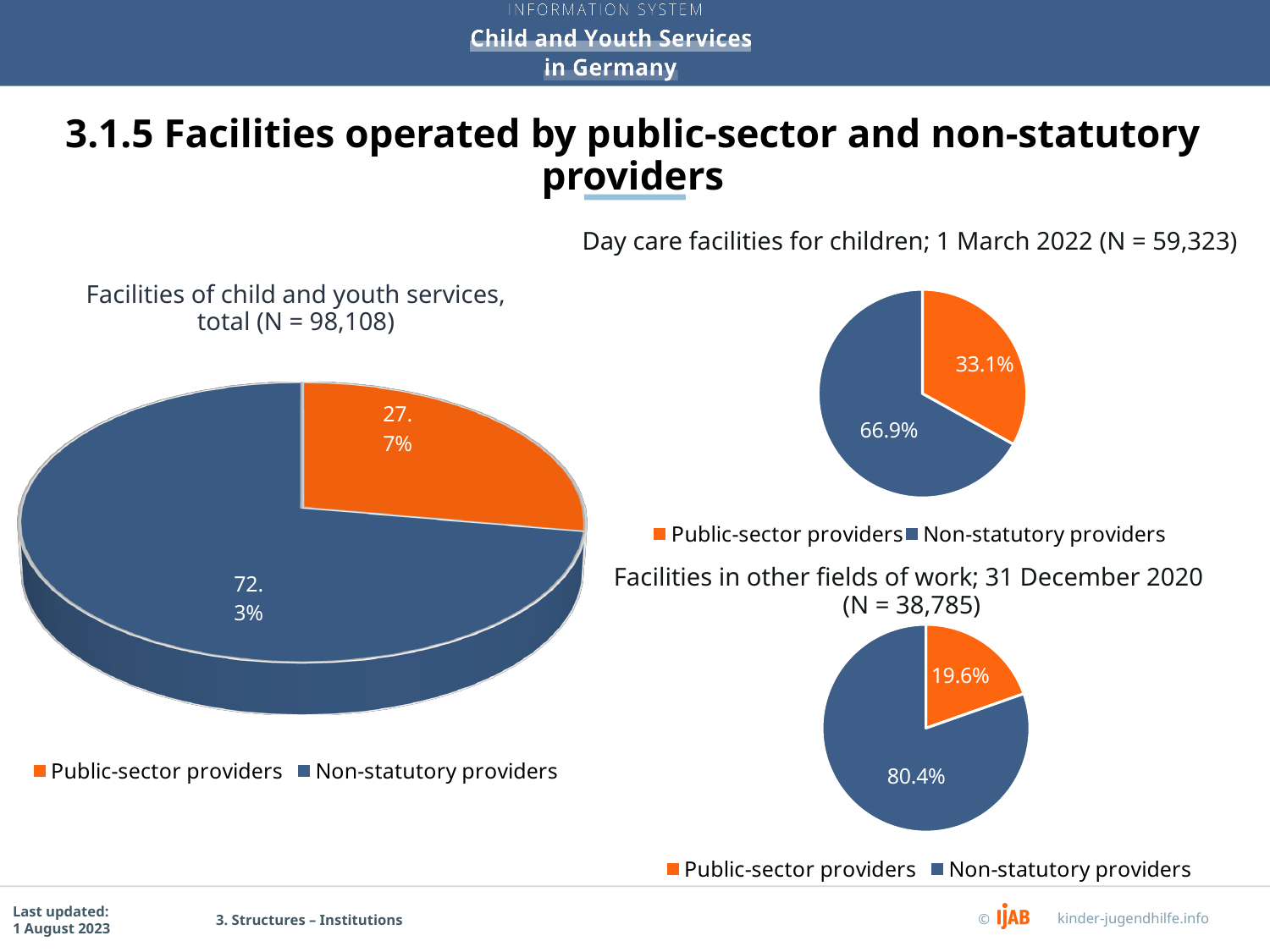
What is the N value given in the title of the 'Day care facilities for children' chart? 59,323 In the 'Facilities in other fields of work' chart, what is the difference in percentage points between non-statutory and public-sector providers? 60.8 In the 'Day care facilities for children' chart, which provider type has the larger share? Non-statutory providers In the 'Day care facilities for children' chart, what share is held by public-sector providers? 33.1% What type of chart is used for 'Day care facilities for children'? Pie chart In the 'Facilities of child and youth services, total' chart, what share is held by public-sector providers? 27.7% How many slices does the 'Facilities of child and youth services, total' pie chart have? 2 In the 'Facilities in other fields of work' chart, what share is held by public-sector providers? 19.6% In the 'Day care facilities for children' chart, what share is held by non-statutory providers? 66.9% In the 'Facilities of child and youth services, total' chart, what share is held by non-statutory providers? 72.3% In the 'Facilities in other fields of work' chart, which provider type has the smaller share? Public-sector providers In the 'Facilities in other fields of work' chart, what share is held by non-statutory providers? 80.4%